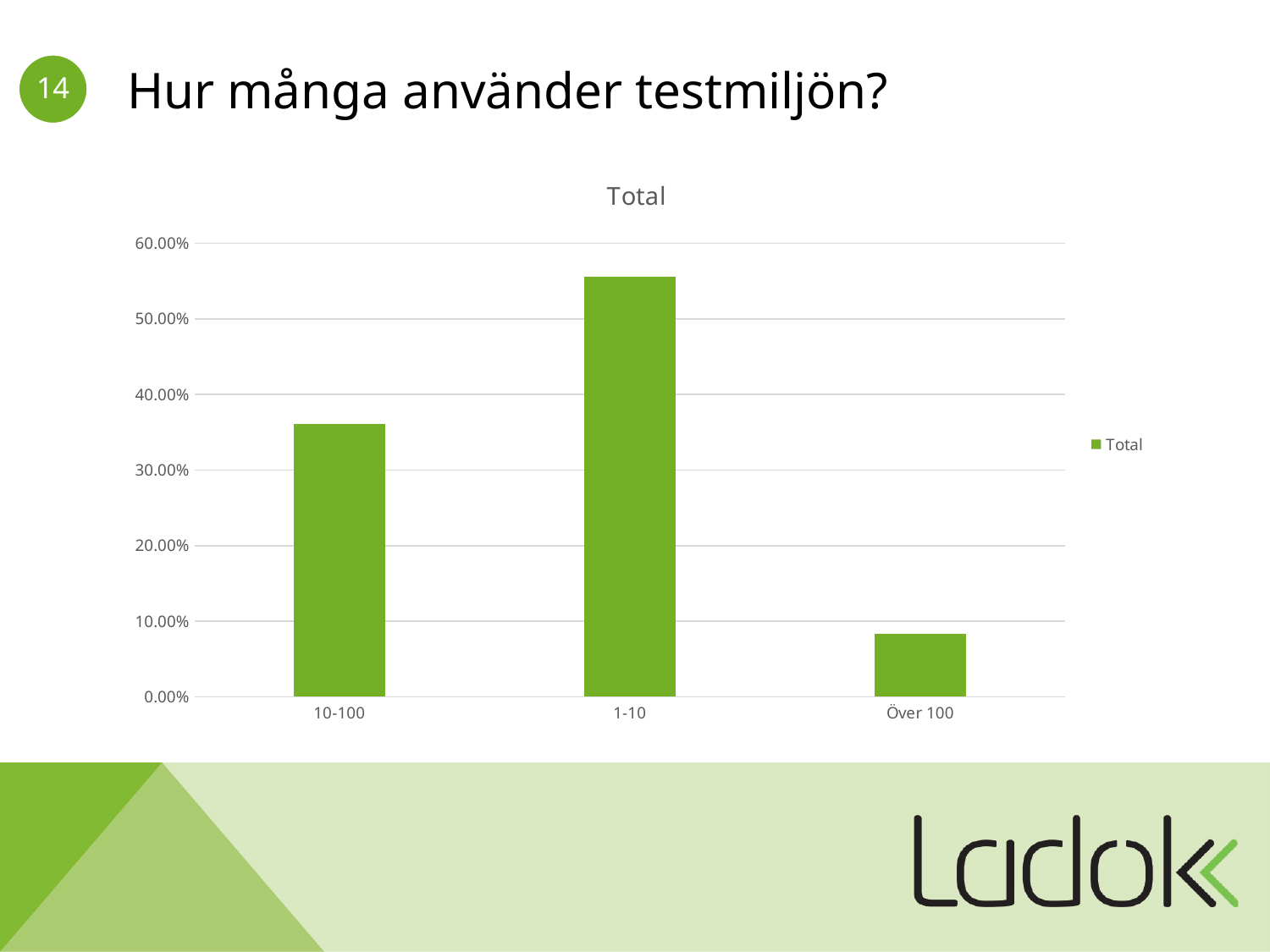
Is the value for 10-100 greater or less than 30.00%? greater How many series does the legend list? 1 What is the name of the series shown in the legend? Total Which is larger, the value for 10-100 or the value for Över 100? 10-100 Is the value for 10-100 greater or less than 40.00%? less What kind of chart is shown on the slide? bar chart How many categories are shown on the x axis of the chart? 3 Is the value for Över 100 greater or less than 10.00%? less What is the title of the chart? Total Which category has the lowest value? Över 100 Which category has the highest value? 1-10